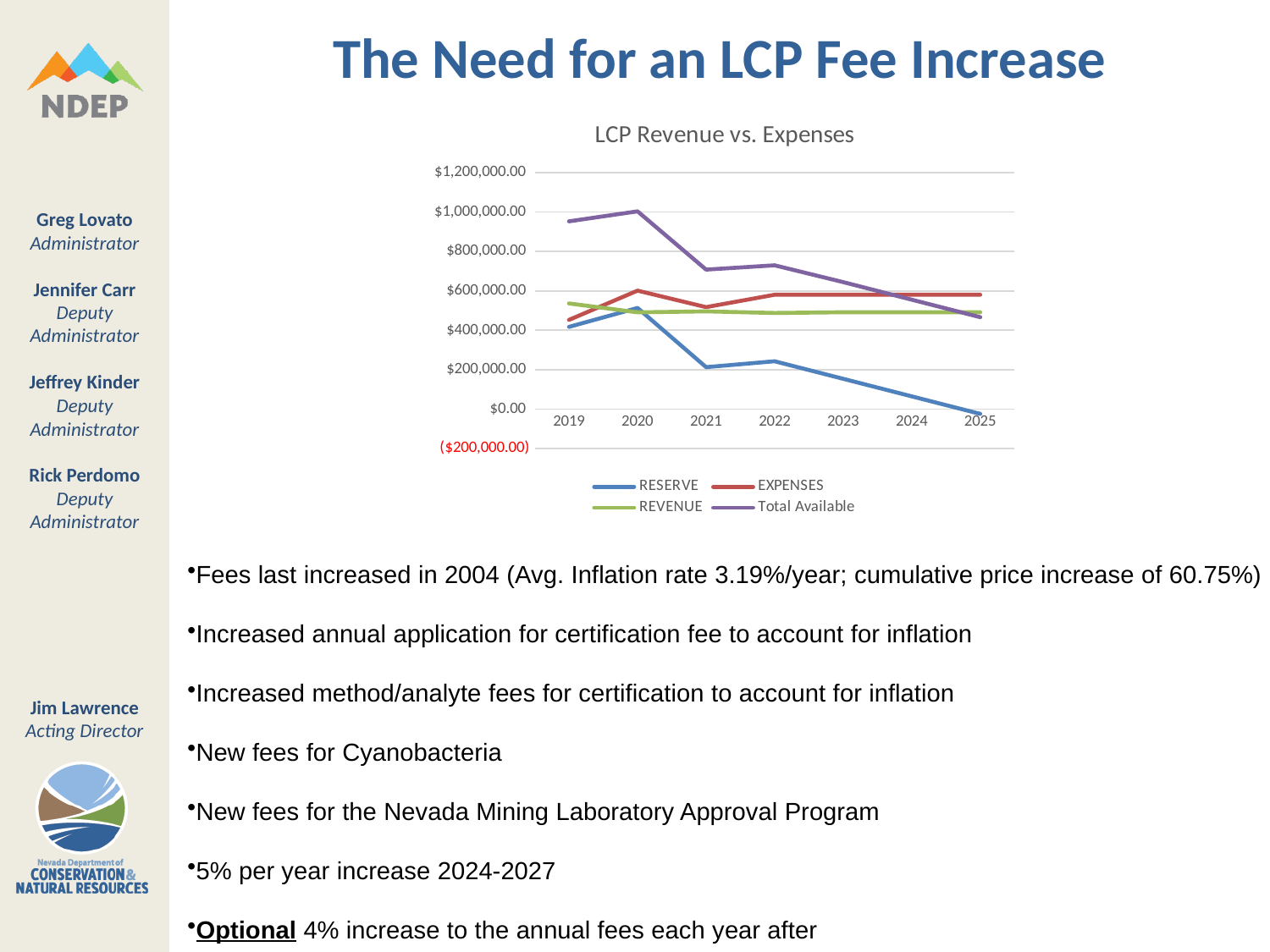
In which year is the Total Available line at its highest? 2020 What is the title of the chart? LCP Revenue vs. Expenses Which is larger in 2019, Total Available or RESERVE? Total Available Does the RESERVE line rise or fall from 2020 to 2025? Fall In which year is the RESERVE line at its lowest? 2025 How many series does the chart legend list? 4 Is the RESERVE value for 2023 greater or less than $200,000.00? less What kind of chart is shown on the slide? Line chart Is the RESERVE value for 2021 greater or less than $400,000.00? less Is the Total Available value for 2019 greater or less than $800,000.00? greater How many years are shown on the x axis of the chart? 7